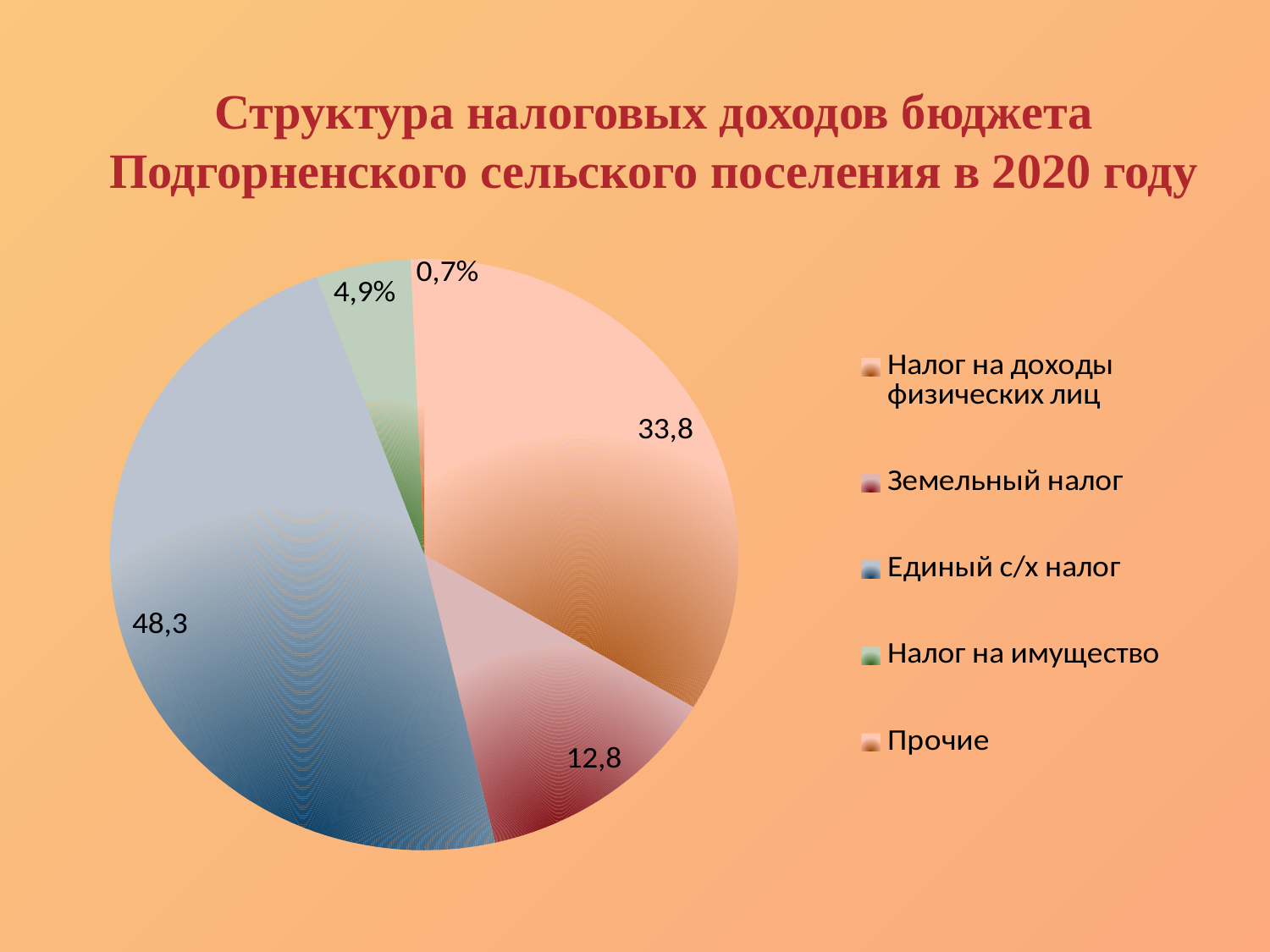
What is the difference between the values for Единый с/х налог and Налог на доходы физических лиц? 14,5 Which is larger, Налог на доходы физических лиц or Земельный налог? Налог на доходы физических лиц What is the value shown for Прочие? 0,7% What is the title of the chart? Структура налоговых доходов бюджета Подгорненского сельского поселения в 2020 году What is the value shown for Единый с/х налог? 48,3 What is the value shown for Налог на имущество? 4,9% What kind of chart is shown on the slide? pie chart Which category has the smallest slice of the pie? Прочие What is the value shown for Налог на доходы физических лиц? 33,8 What is the value shown for Земельный налог? 12,8 How many categories does the legend list? 5 Which category has the largest slice of the pie? Единый с/х налог